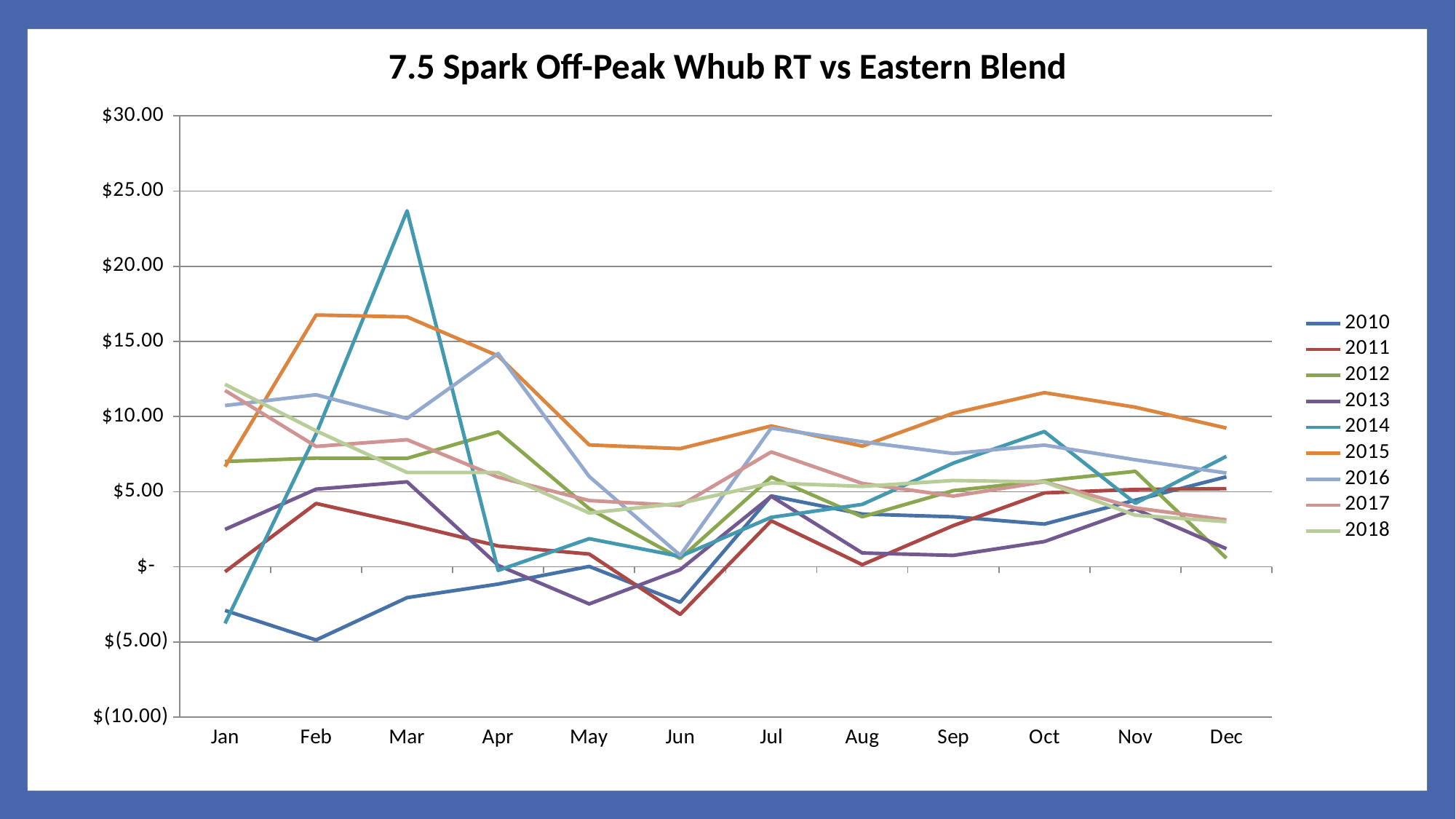
Which series has the highest value in Mar? 2014 What is the title of the chart? 7.5 Spark Off-Peak Whub RT vs Eastern Blend What kind of chart is shown on the slide? line chart Does the 2014 series rise or fall from Mar to Apr? fall Which is larger in Jan, the value for 2015 or the value for 2010? 2015 How many months are shown along the x axis? 12 Which series has the highest value in Oct? 2015 Which series has the lowest value in May? 2013 Is the value for 2015 in Feb greater or less than $15.00? greater Is the value for 2014 in Mar greater or less than $20.00? greater Which series has the lowest value in Feb? 2010 How many series does the legend list? 9